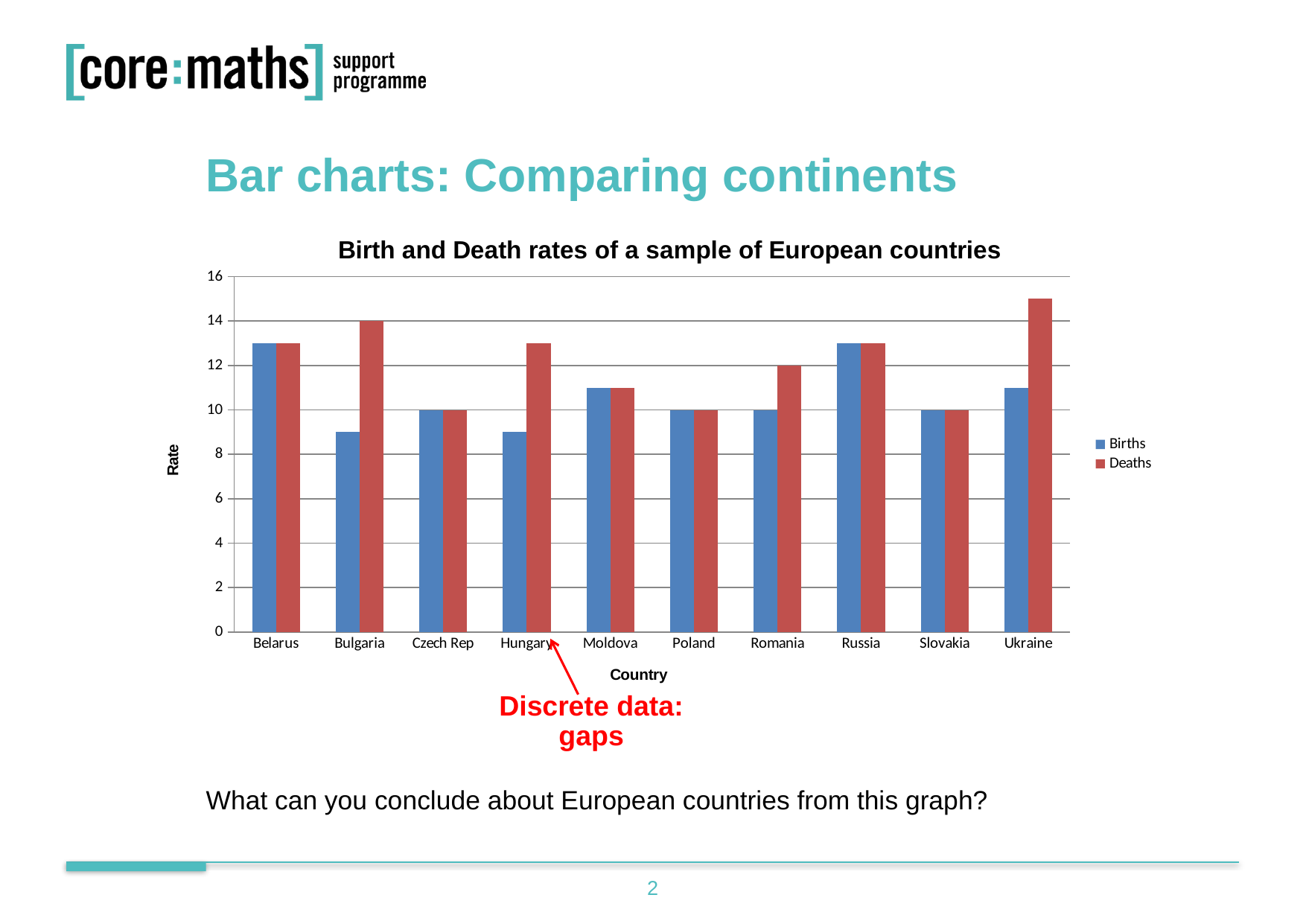
What kind of chart is shown on the slide? Bar chart What is the death rate for Romania? 12 Is the death rate for Ukraine greater or less than 14? greater How many countries are shown on the x axis? 10 How many series does the legend list? 2 What is the death rate for Bulgaria? 14 What is the title of the chart? Birth and Death rates of a sample of European countries Which country has the highest death rate? Ukraine For Bulgaria, which is larger, Births or Deaths? Deaths Is the birth rate for Hungary greater or less than 10? less What is the difference between the death rate and the birth rate for Romania? 2 What is the birth rate for Czech Rep? 10